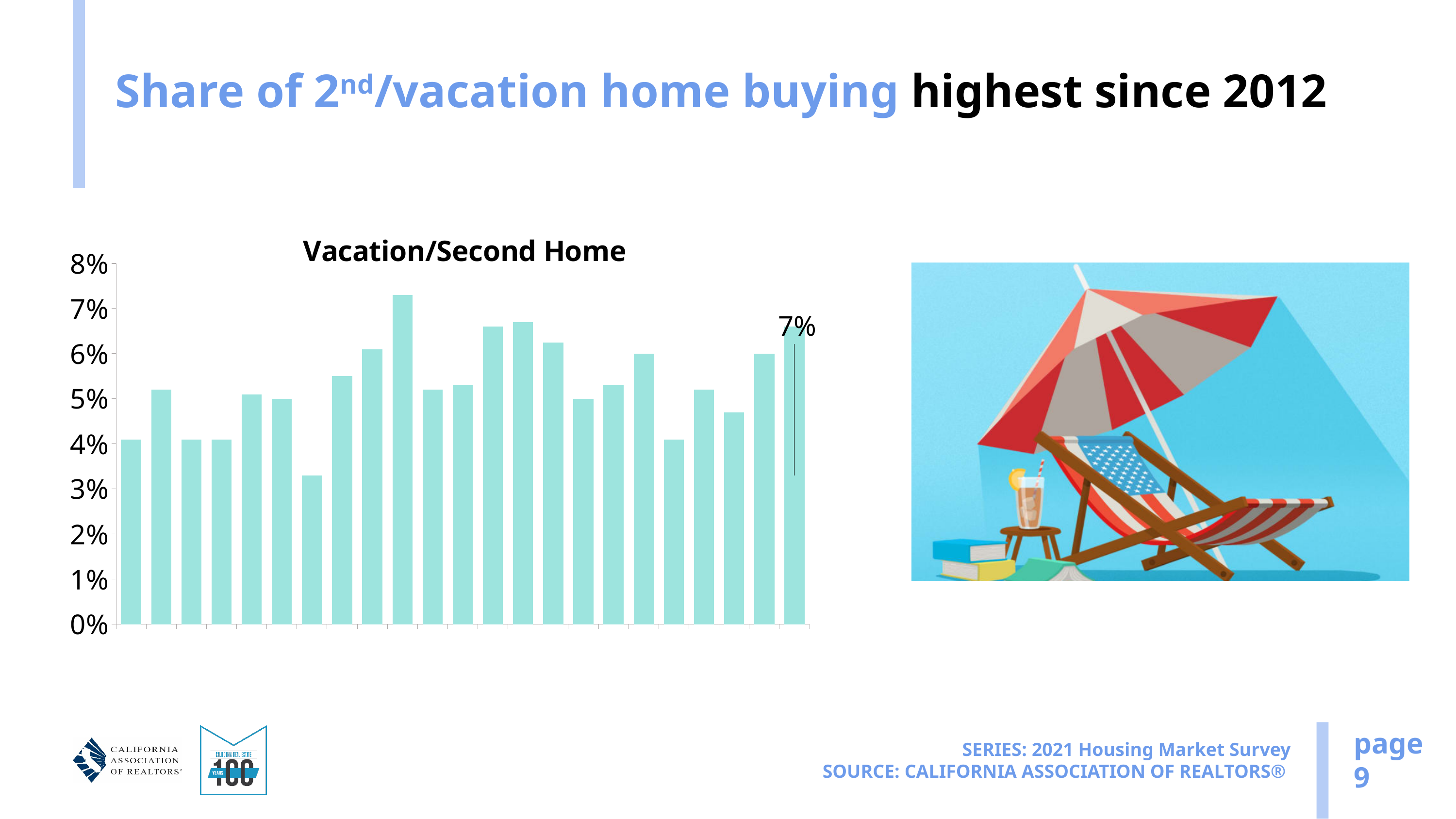
Which is larger, the value of the last bar or the value of the first bar? the last bar How many bars are plotted in the chart? 23 What is the title of the chart? Vacation/Second Home Is the value of the rightmost bar greater or less than 6%? greater Is the value of the second bar from the left greater or less than 5%? greater Is the value of the first (leftmost) bar greater or less than 5%? less What kind of chart is shown on the slide? bar chart What is the highest value shown on the vertical axis of the chart? 8% What value is labelled on the last (rightmost) bar of the chart? 7%